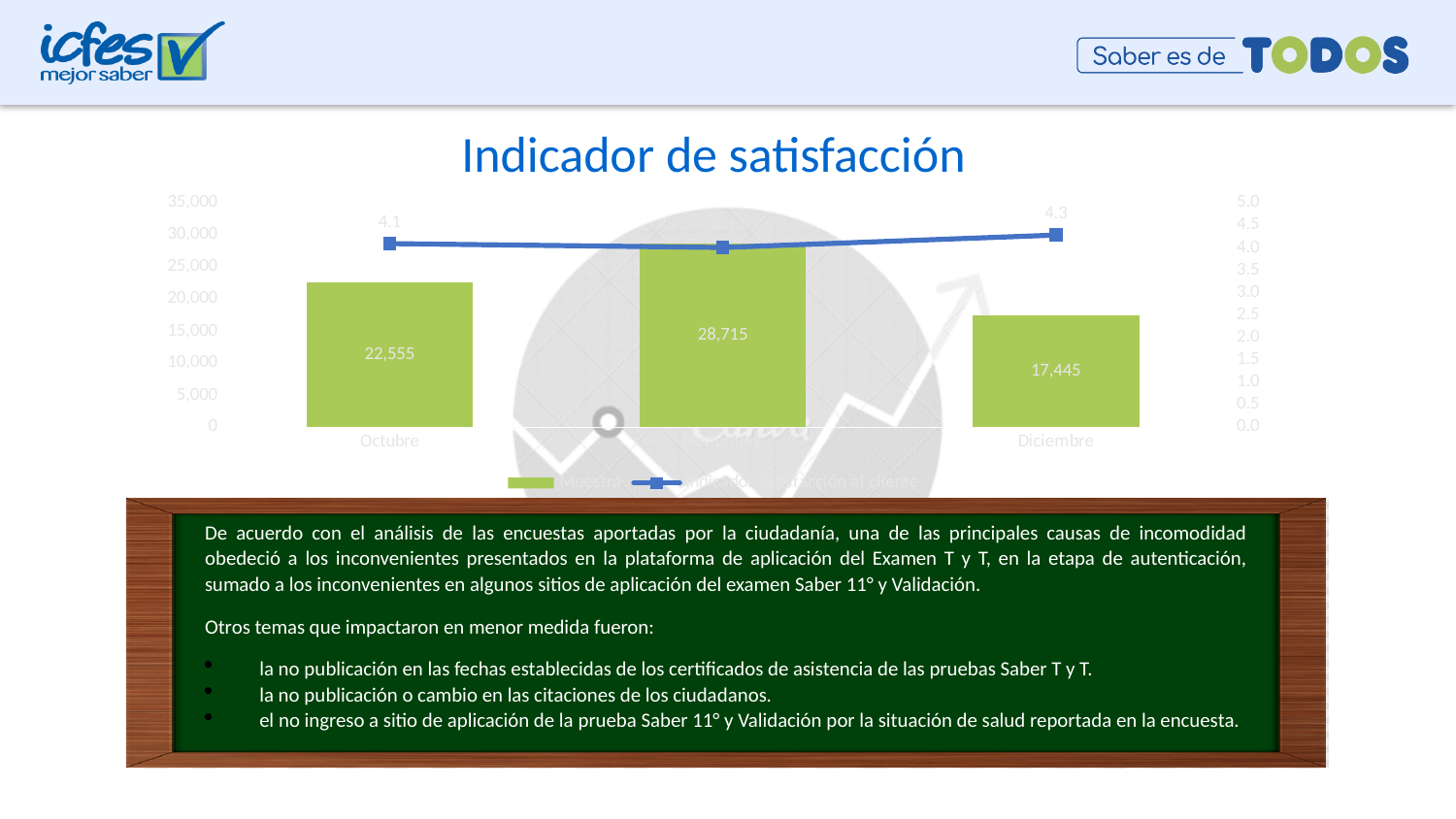
Which has the larger bar value, Octubre or Diciembre? Octubre What is the title of the chart? Indicador de satisfacción What kind of chart is shown on the slide? Bar chart with a line series What is the difference between the bar values for Octubre and Diciembre? 5,110 What is the line value for Octubre? 4.1 What is the bar value for Octubre? 22,555 How many bars are plotted in the chart? 3 What is the value labelled on the middle bar of the chart? 28,715 What is the line value for Diciembre? 4.3 Does the line value rise or fall from Octubre to Diciembre? rise Is the bar value for Diciembre greater or less than 20,000? less What is the bar value for Diciembre? 17,445